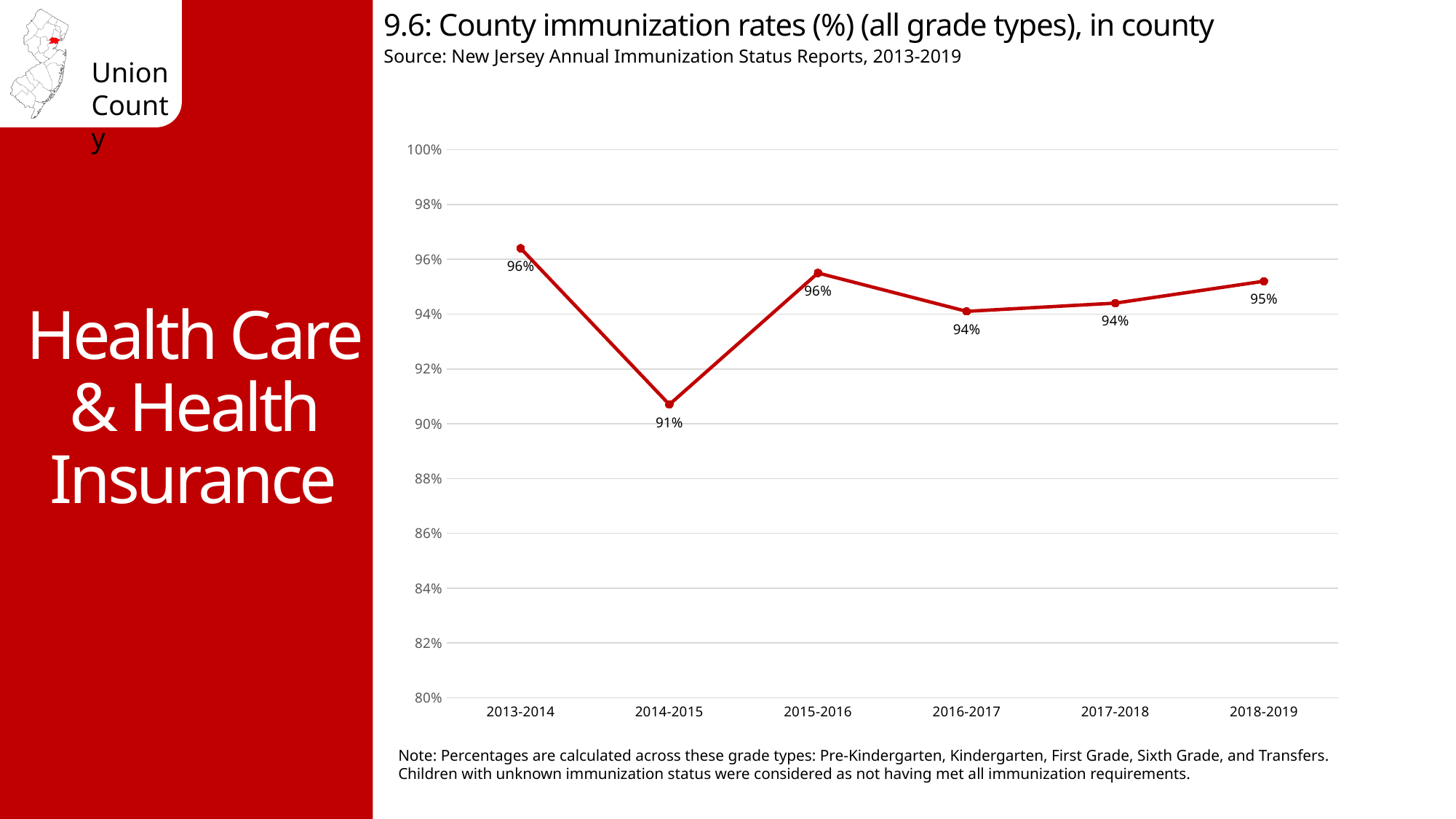
What is the county immunization rate for 2014-2015? 91% Which school year has the lowest county immunization rate? 2014-2015 Is the immunization rate for 2018-2019 greater or less than 94%? greater What is the county immunization rate for 2016-2017? 94% Does the immunization rate rise or fall from 2016-2017 to 2018-2019? rise What is the difference in percentage points between the immunization rate in 2013-2014 and in 2014-2015? 5 What kind of chart is shown on the slide? line chart Is the immunization rate for 2014-2015 greater or less than 92%? less What is the county immunization rate for 2018-2019? 95% How many school years are plotted on the chart? 6 Which is larger, the immunization rate for 2018-2019 or for 2014-2015? 2018-2019 What is the county immunization rate for 2013-2014? 96%